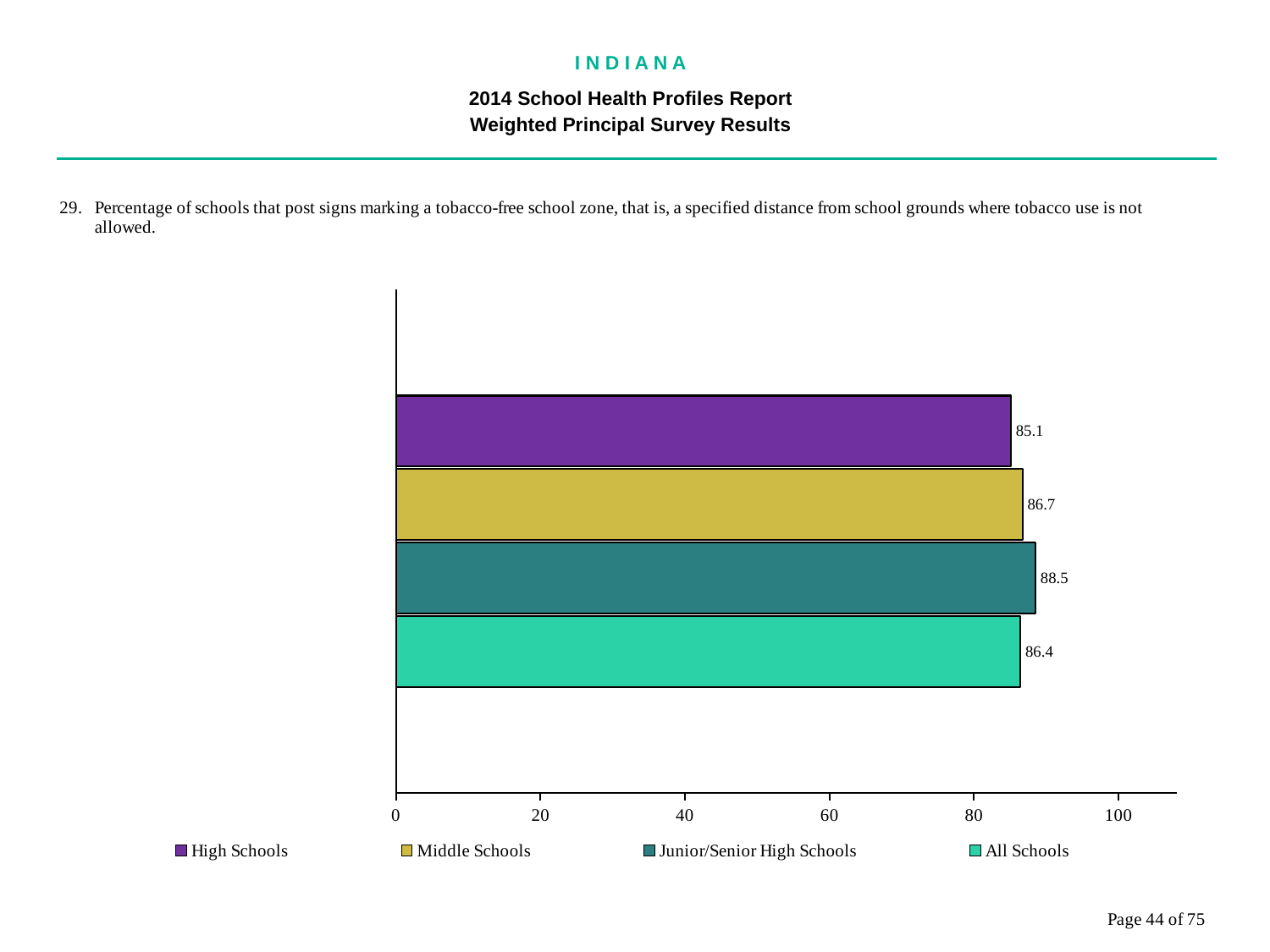
Is the value for All Schools greater or less than 80? greater Which school type has the lowest value? High Schools How many bars are plotted in the chart? 4 Which school type has the highest value? Junior/Senior High Schools What is the value for High Schools? 85.1 What is the value for Junior/Senior High Schools? 88.5 What is the difference between the values for Junior/Senior High Schools and High Schools? 3.4 What kind of chart is shown on the slide? bar chart Which is larger, the value for Middle Schools or the value for High Schools? Middle Schools How many entries does the legend list? 4 What is the value for All Schools? 86.4 What is the value for Middle Schools? 86.7